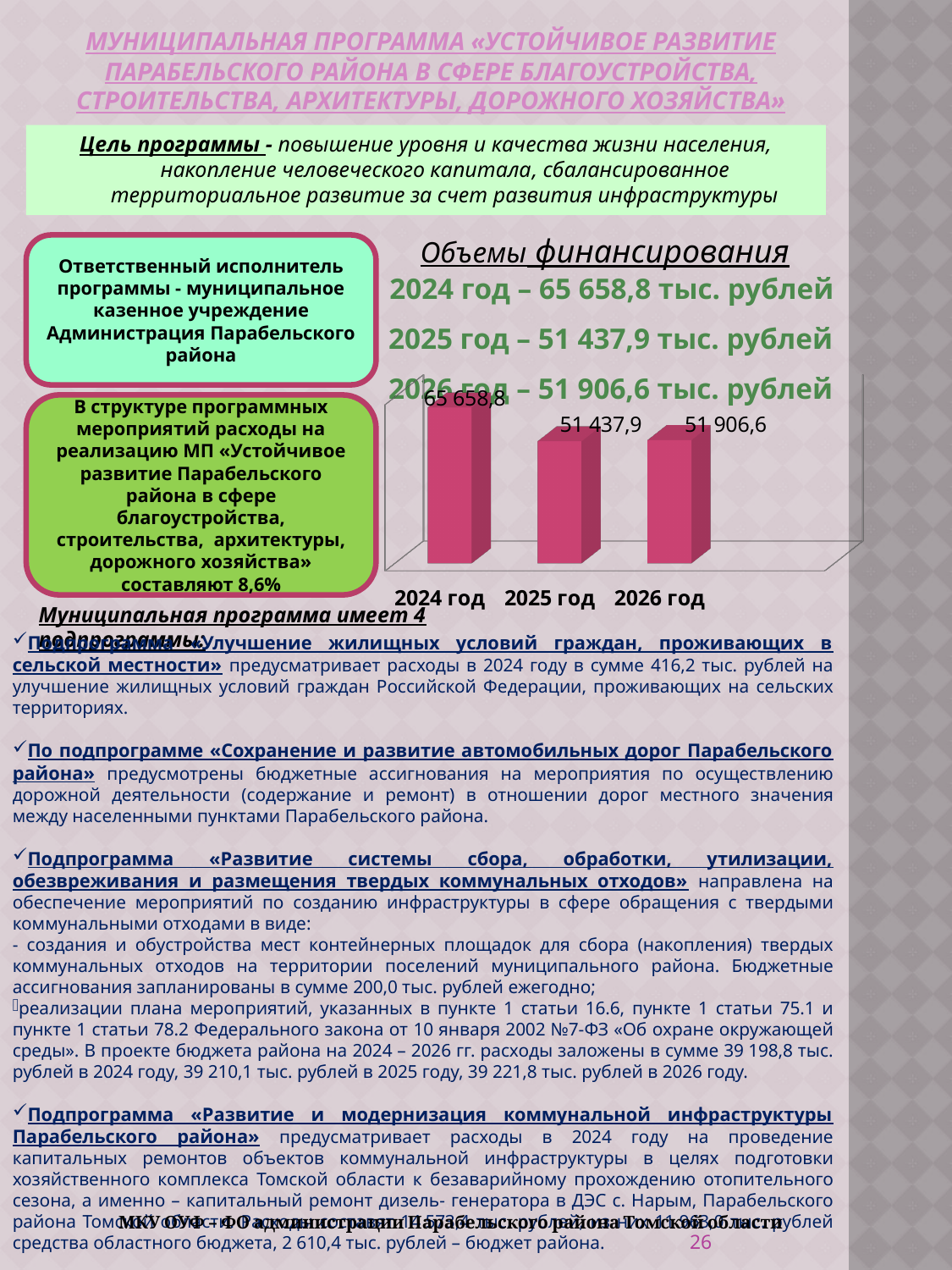
What is the value shown for 2024 год in the chart? 65 658,8 What is the title shown above the chart? Объемы финансирования What is the value shown for 2026 год in the chart? 51 906,6 What is the difference between the values for 2024 год and 2025 год? 14 220,9 Which year has the lowest value in the chart? 2025 год Which year has the highest value in the chart? 2024 год Does the value fall or rise from 2024 год to 2025 год? fall How many years (categories) are plotted in the chart? 3 What kind of chart is shown on the slide? bar chart Which is larger, the value for 2024 год or the value for 2026 год? 2024 год What is the value shown for 2025 год in the chart? 51 437,9 What is the difference between the values for 2026 год and 2025 год? 468,7